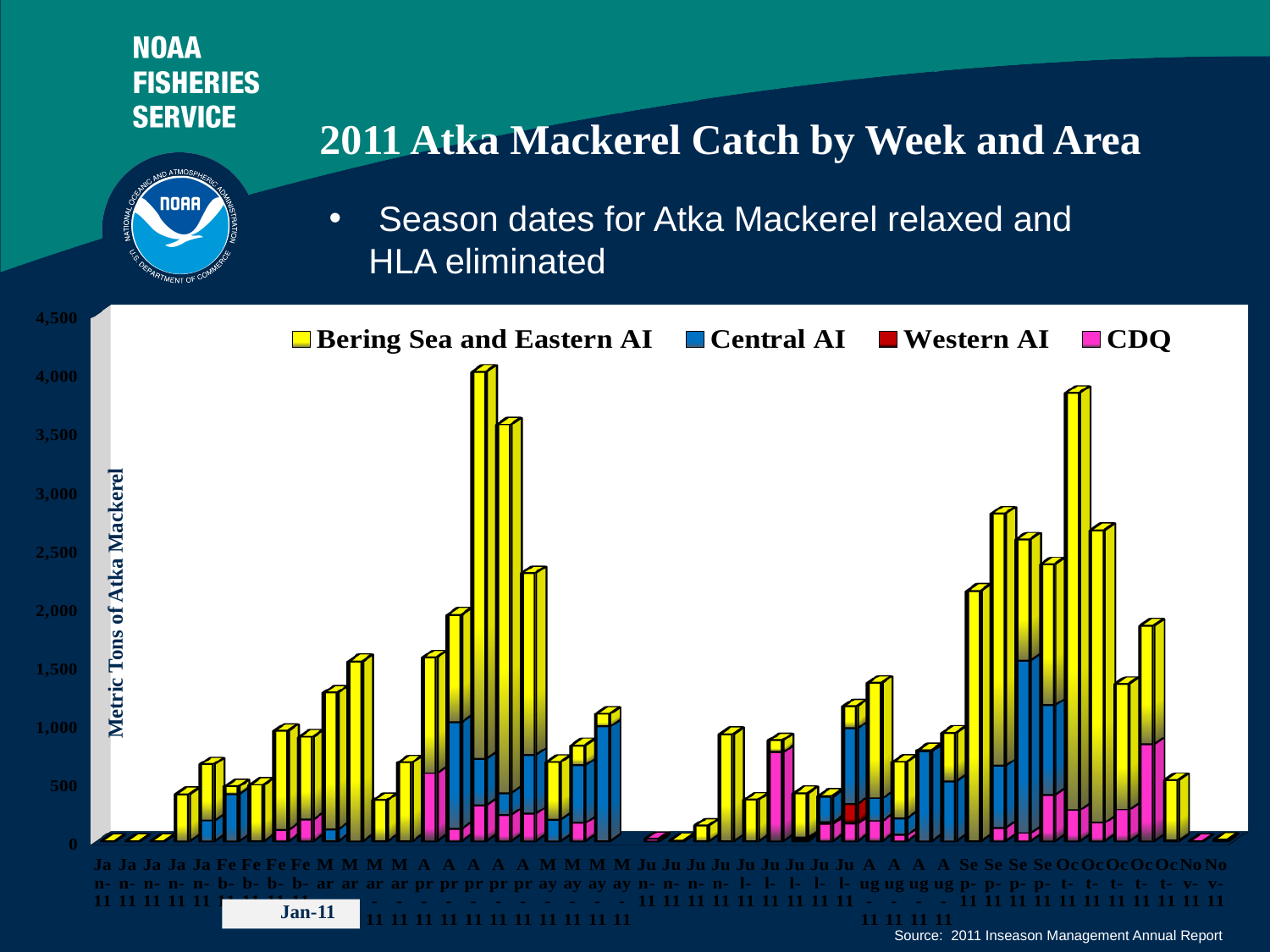
What is the label on the vertical axis? Metric Tons of Atka Mackerel Is the value of the tallest bar greater or less than 3,500? greater How many series does the legend list? 4 Which series makes up the largest part of the tallest bar? Bering Sea and Eastern AI Is the tallest bar in the first half of the year (January to June) or the second half (July to November)? First half (April) Which series is shown in yellow in the legend? Bering Sea and Eastern AI What kind of chart is shown on the slide? Stacked bar chart Do the weekly totals rise or fall from the start of January through the peak in April? rise Is the value of the tallest bar greater or less than 4,500? less What is the highest value shown on the vertical axis? 4,500 Is the value of the tallest October bar greater or less than 3,500? greater